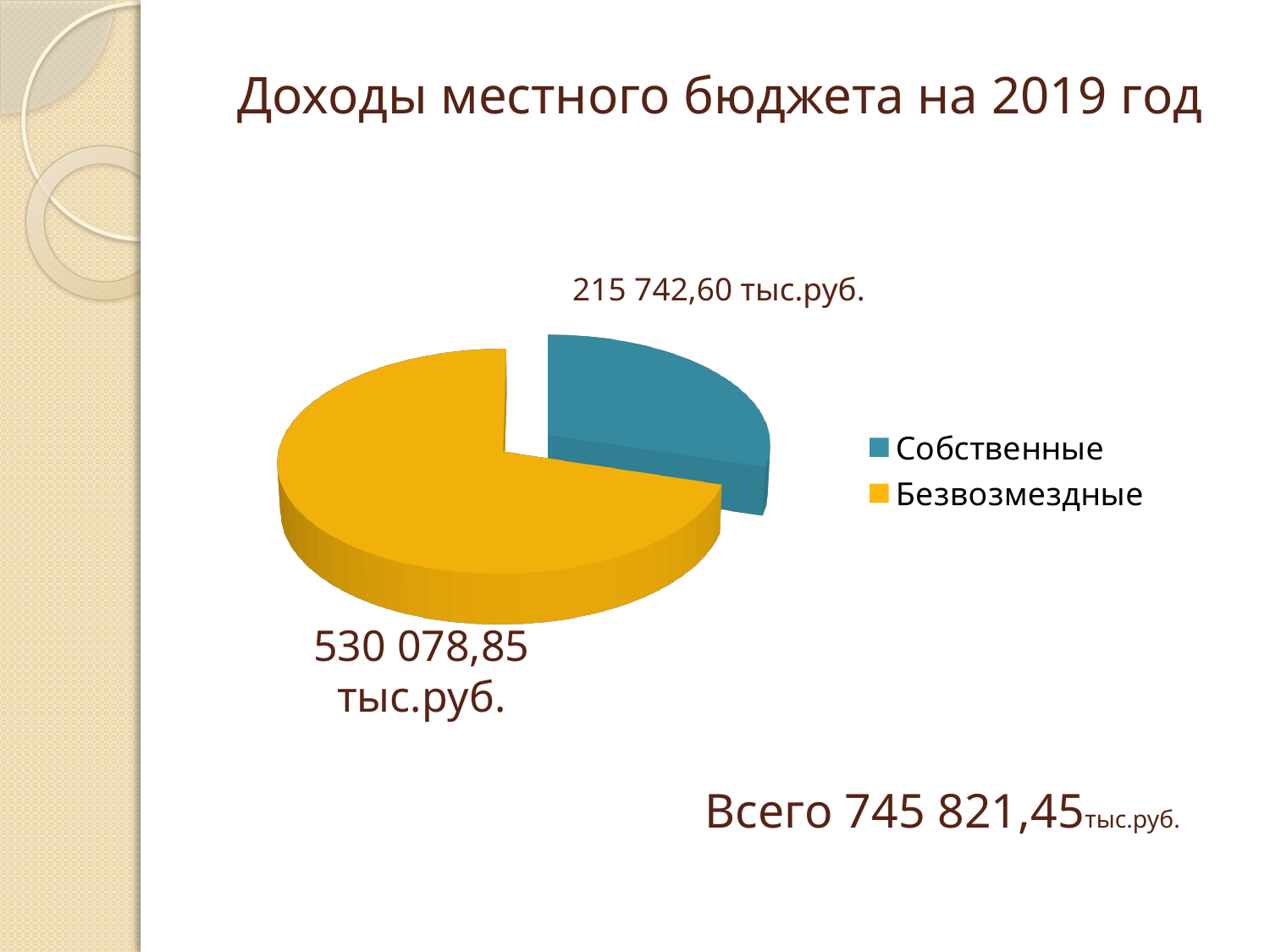
What kind of chart is shown on the slide? Pie chart What is the value for Собственные? 215 742,60 тыс.руб. What is the total of all slices shown on the slide? 745 821,45 тыс.руб. How many slices does the pie chart have? 2 What is the title of the slide? Доходы местного бюджета на 2019 год Which category has the smallest slice of the pie? Собственные Which category has the largest slice of the pie? Безвозмездные What colour is the Безвозмездные slice? Yellow How many entries does the legend list? 2 Which is larger, Собственные or Безвозмездные? Безвозмездные What is the value for Безвозмездные? 530 078,85 тыс.руб. What is the difference between Безвозмездные and Собственные? 314 336,25 тыс.руб.